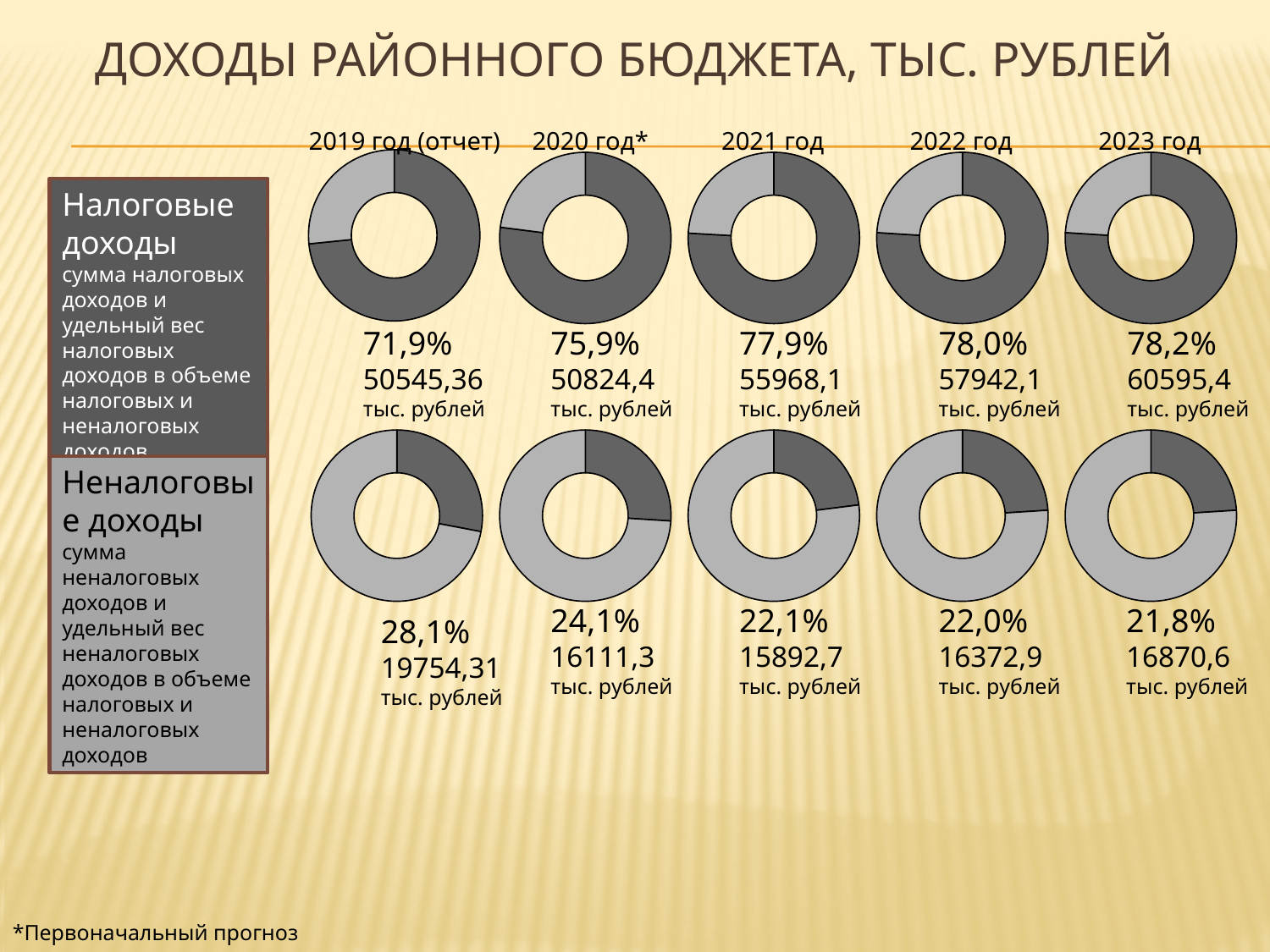
In the Неналоговые доходы row, by how many percentage points does the 2019 год (отчет) share exceed the 2023 год share? 6,3 What kind of chart is used on this slide? Doughnut (pie) chart In the Налоговые доходы row, what share of the total does the 2021 год chart show for tax revenues? 77,9% In the Неналоговые доходы row, which year has the lowest amount in тыс. рублей? 2021 год In the Неналоговые доходы row, which is larger: the amount for 2022 год or for 2020 год*? 2022 год How many doughnut charts are on the slide? 10 In the Налоговые доходы row, what share is shown for the 2019 год (отчет) chart? 71,9% In the Налоговые доходы row, what is the difference between the 2023 год amount and the 2019 год (отчет) amount? 10050,04 тыс. рублей What is the title of the slide containing the charts? Доходы районного бюджета, тыс. рублей In the Налоговые доходы row, does the share rise or fall from 2019 to 2023? Rises In the Неналоговые доходы row, what amount is shown for the 2023 год chart? 16870,6 тыс. рублей In the Налоговые доходы row, which year has the highest share? 2023 год